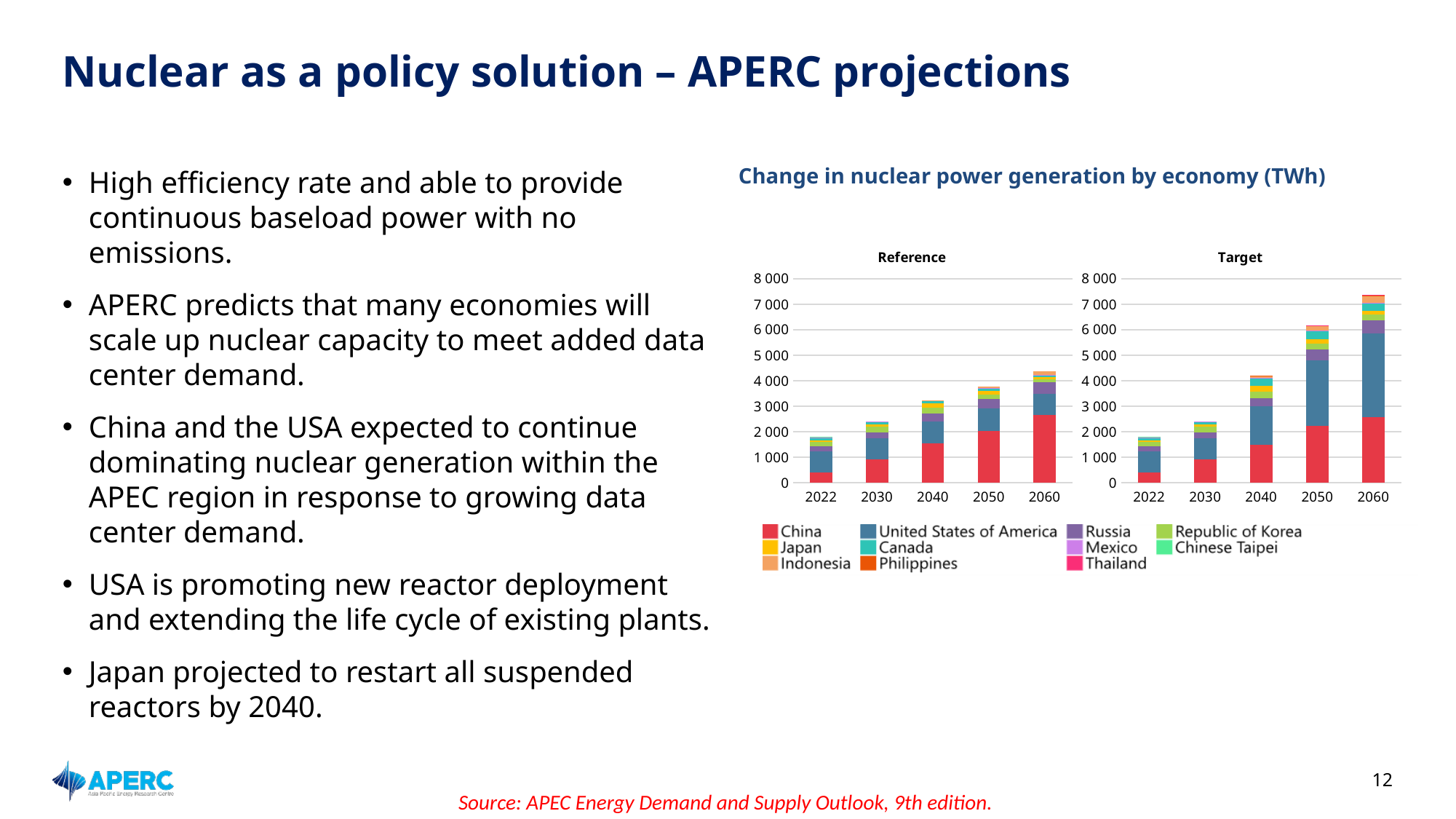
In the Target chart, which year has the lowest total nuclear generation? 2022 Is the total for 2050 in the Target chart greater or less than 5 000? greater Is the total for 2060 in the Reference chart greater or less than 4 000? greater What is the title above the two charts? Change in nuclear power generation by economy (TWh) Which is larger: the 2060 total in the Target chart or the 2060 total in the Reference chart? Target In the Reference chart, which year has the highest total nuclear generation? 2060 What kind of chart is the Reference chart? Stacked bar chart How many years are shown on the x axis of the Target chart? 5 How many economies does the legend list? 11 In the Target chart, do the total bar heights rise or fall from 2022 to 2060? Rise Is the total for 2060 in the Target chart greater or less than 7 000? greater